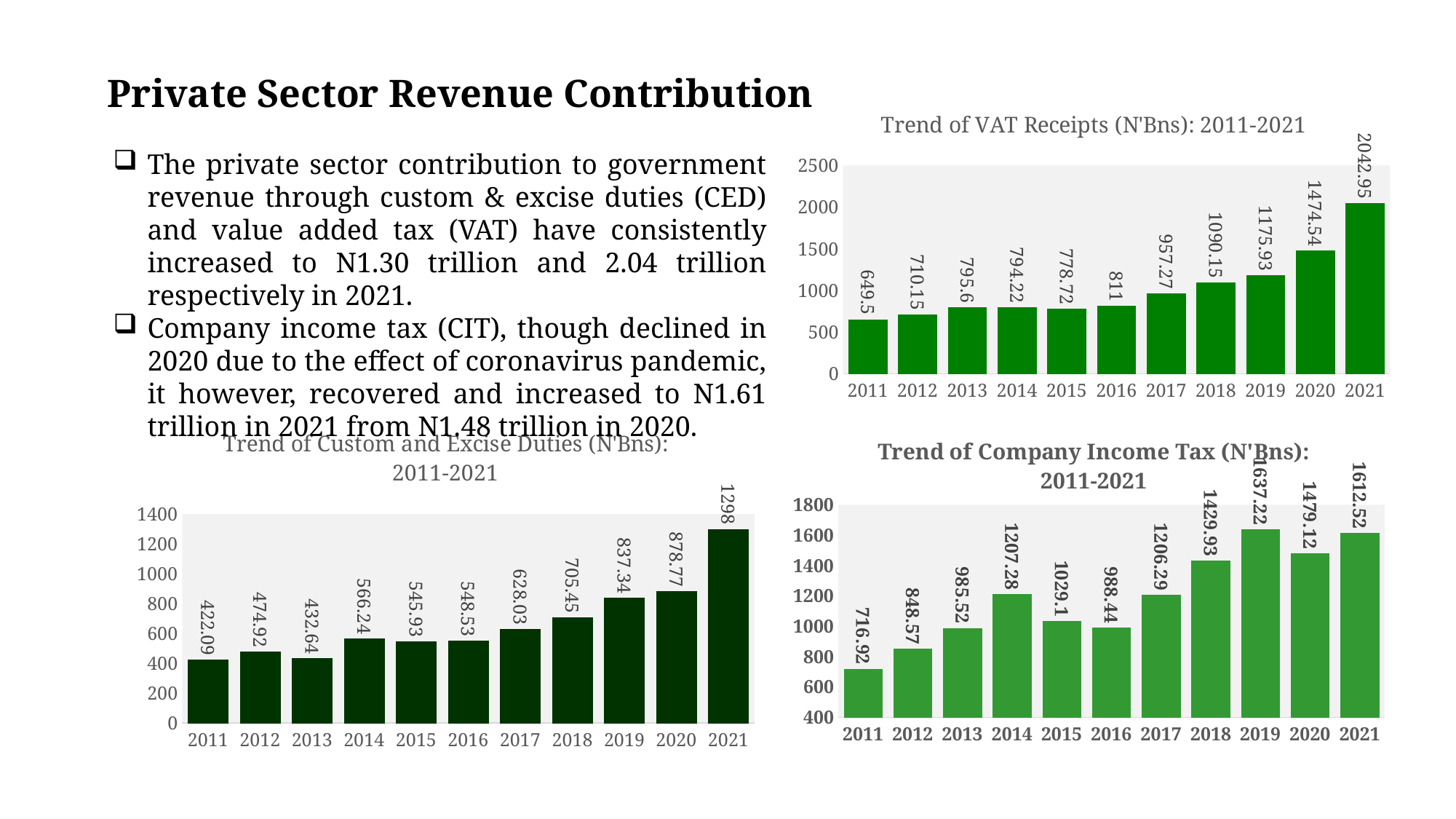
In the 'Trend of VAT Receipts (N'Bns): 2011-2021' chart, what is the value for 2017? 957.27 In the 'Trend of VAT Receipts (N'Bns): 2011-2021' chart, which year has the lowest value? 2011 In the 'Trend of Custom and Excise Duties (N'Bns): 2011-2021' chart, is the value for 2019 larger than the value for 2018? Yes In the 'Trend of Company Income Tax (N'Bns): 2011-2021' chart, which year has the highest value? 2019 In the 'Trend of Company Income Tax (N'Bns): 2011-2021' chart, what is the value for 2020? 1479.12 In the 'Trend of VAT Receipts (N'Bns): 2011-2021' chart, what is the difference between the 2021 and 2020 values? 568.41 In the 'Trend of VAT Receipts (N'Bns): 2011-2021' chart, which year has the highest value? 2021 What kind of chart is the 'Trend of Company Income Tax (N'Bns): 2011-2021' chart? Bar chart In the 'Trend of Custom and Excise Duties (N'Bns): 2011-2021' chart, what is the value for 2014? 566.24 In the 'Trend of Custom and Excise Duties (N'Bns): 2011-2021' chart, how many years are plotted? 11 In the 'Trend of Custom and Excise Duties (N'Bns): 2011-2021' chart, which year has the lowest value? 2011 In the 'Trend of Company Income Tax (N'Bns): 2011-2021' chart, what is the difference between the 2021 and 2020 values? 133.4